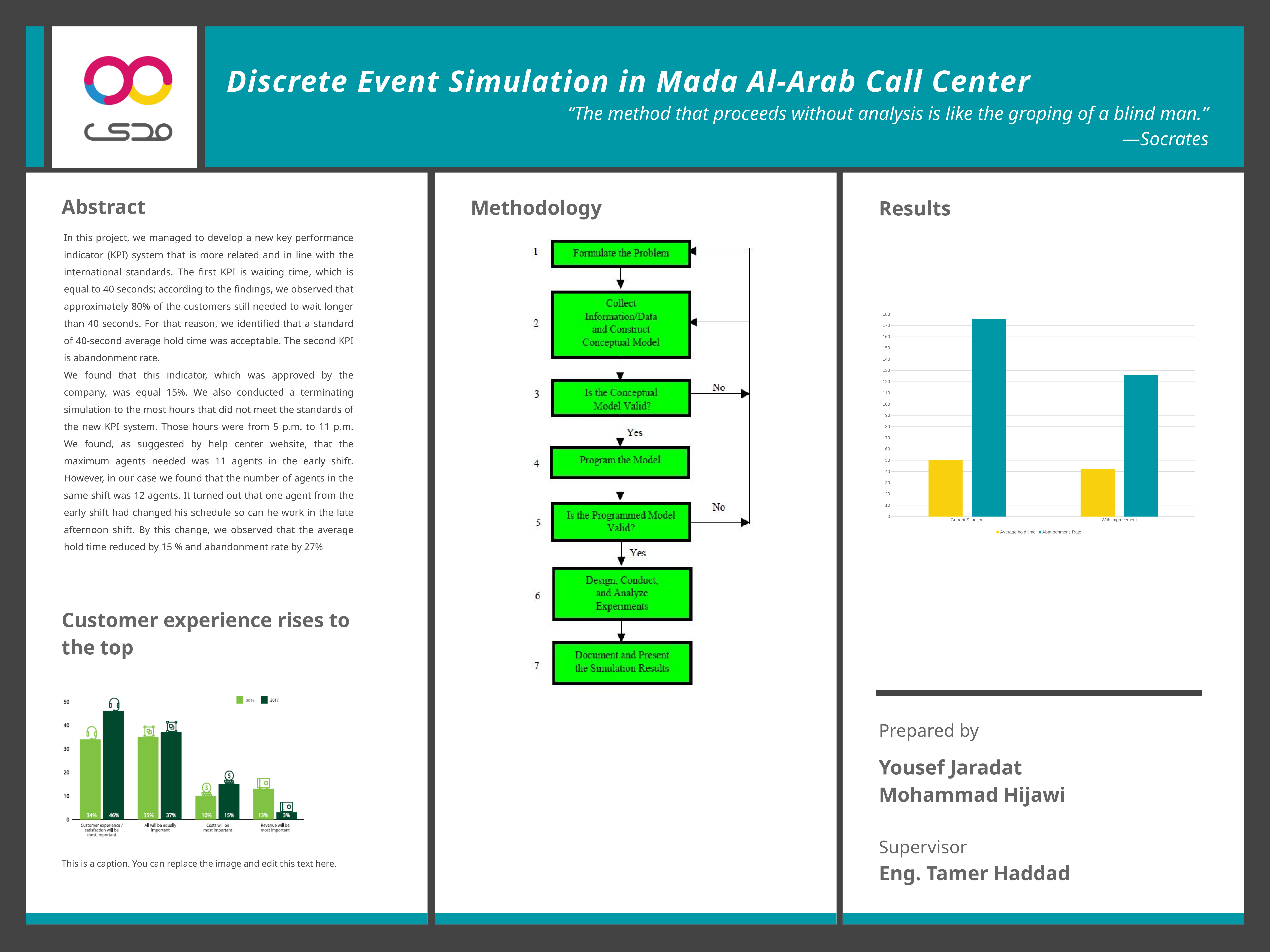
In the Results chart, is the Abandonment Rate value for With improvement greater or less than 130? less In the Results chart, what kind of chart is shown? bar chart In the 'Customer experience rises to the top' chart, what is the 2015 value for 'Costs will be most important'? 10% In the Results chart, is the Average hold time value for With improvement greater or less than 50? less In the 'Customer experience rises to the top' chart, what is the 2017 value for 'Customer experience / satisfaction will be most important'? 46% In the Results chart, how many categories are shown on the x axis? 2 In the 'Customer experience rises to the top' chart, which category has the lowest 2017 value? Revenue will be most important In the 'Customer experience rises to the top' chart, how many categories are shown? 4 In the 'Customer experience rises to the top' chart, what is the difference between the 2017 and 2015 values for 'Customer experience / satisfaction will be most important'? 12% In the Results chart, is the Abandonment Rate value for Current Situation greater or less than 170? greater In the Results chart, which category has the higher Abandonment Rate, Current Situation or With improvement? Current Situation In the Results chart, how many series does the legend list? 2